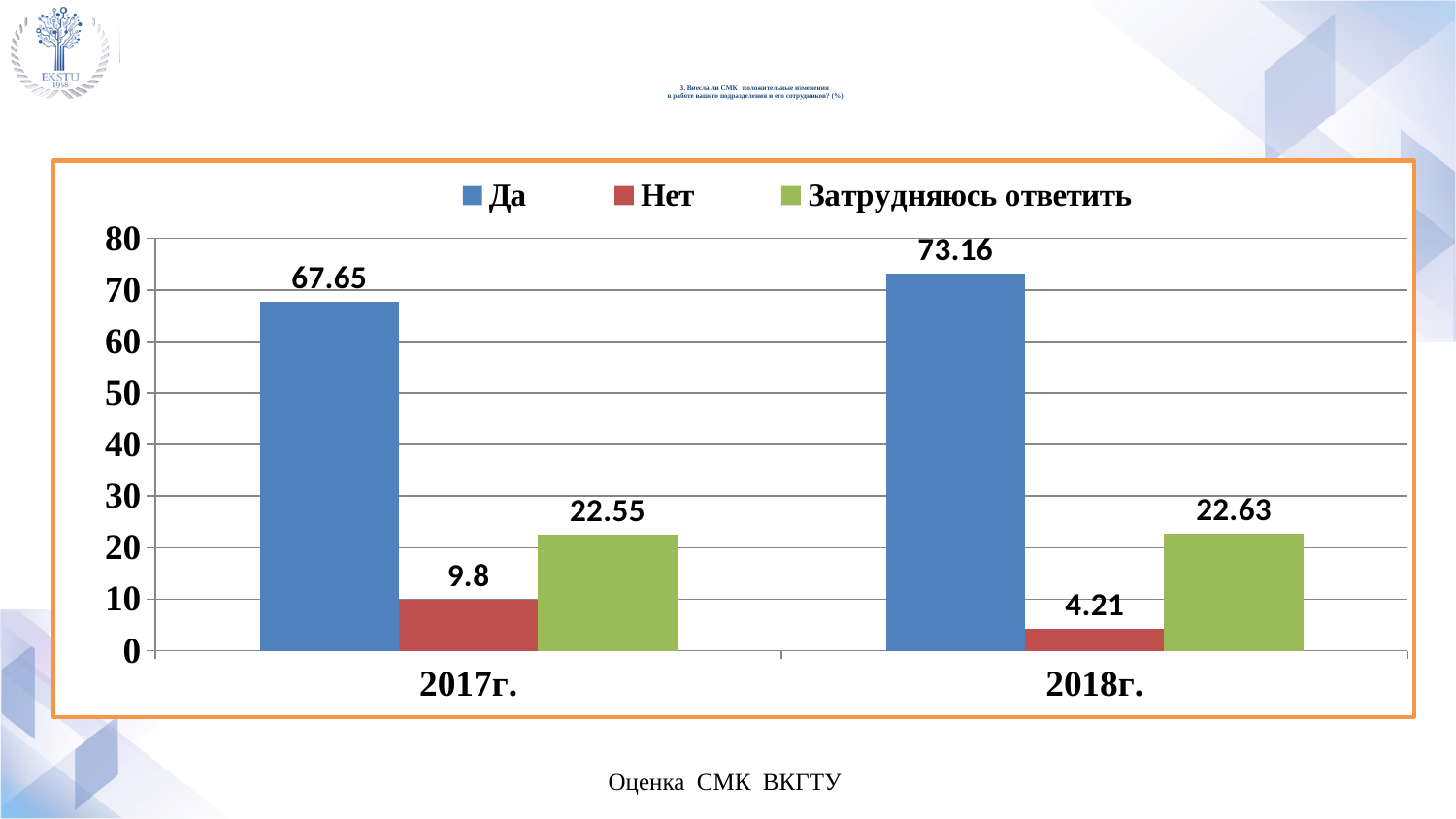
Which is larger: the "Нет" value in 2017г. or in 2018г.? 2017г. Which series has the lowest value in 2017г.? Нет How many categories are shown on the x axis? 2 What is the difference between the "Да" values for 2018г. and 2017г.? 5.51 What colour represents the "Затрудняюсь ответить" series? Green What is the value for "Нет" in 2018г.? 4.21 What is the value for "Да" in 2017г.? 67.65 What is the value for "Да" in 2018г.? 73.16 How many series does the legend list? 3 Which series has the highest value in 2018г.? Да What kind of chart is shown on the slide? Bar chart What is the value for "Затрудняюсь ответить" in 2017г.? 22.55